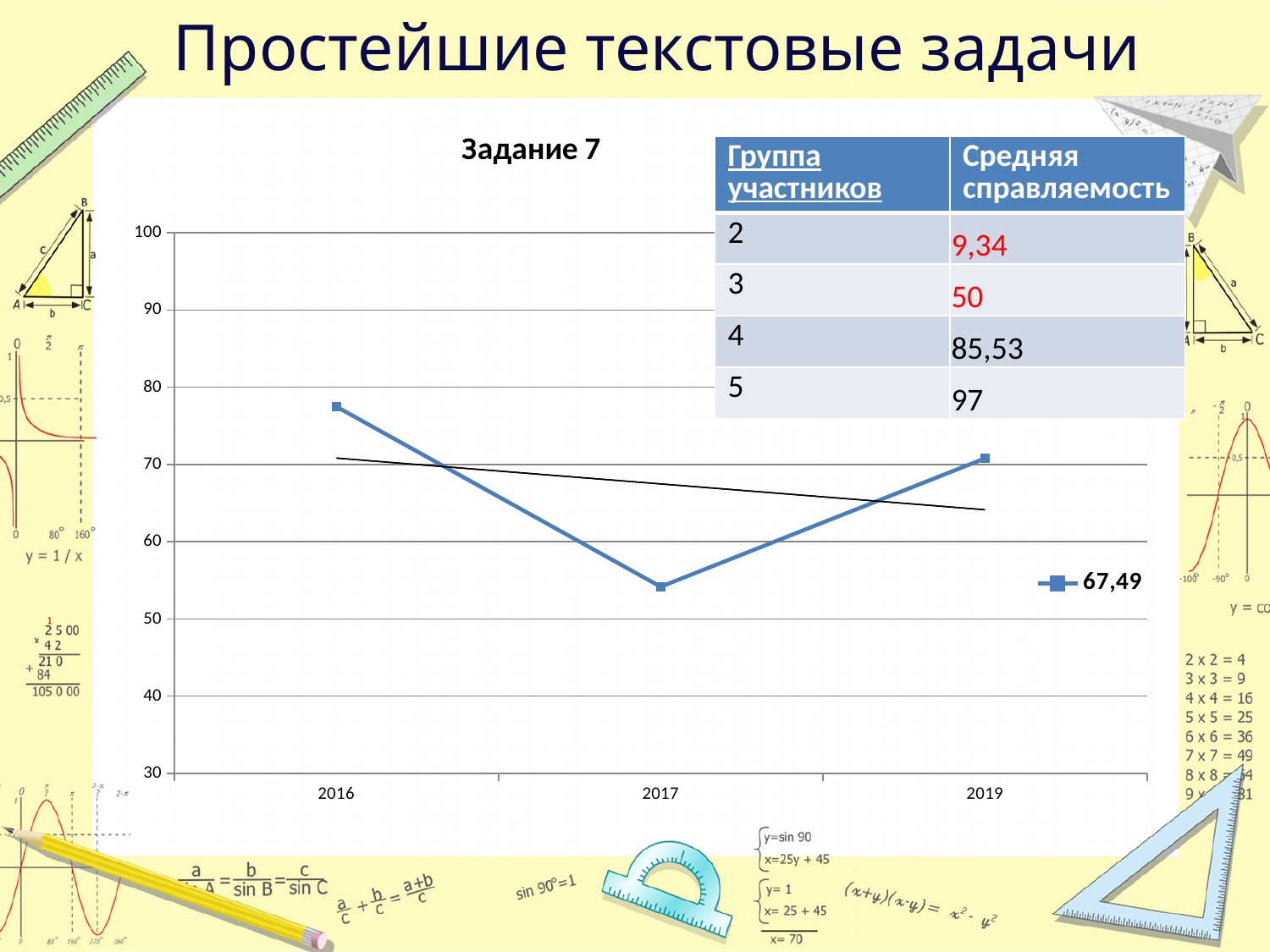
Which is larger, the value for 2016 or the value for 2019? 2016 How many years are plotted along the x axis of the chart? 3 What entry does the chart legend show? 67,49 Which year has the highest value on the chart? 2016 Is the value for 2019 greater or less than 80? less Is the value for 2016 greater or less than 70? greater Does the value rise or fall from 2017 to 2019? rise Is the value for 2017 greater or less than 60? less What is the title of the chart? Задание 7 Which year has the lowest value on the chart? 2017 What kind of chart is shown on the slide? line chart